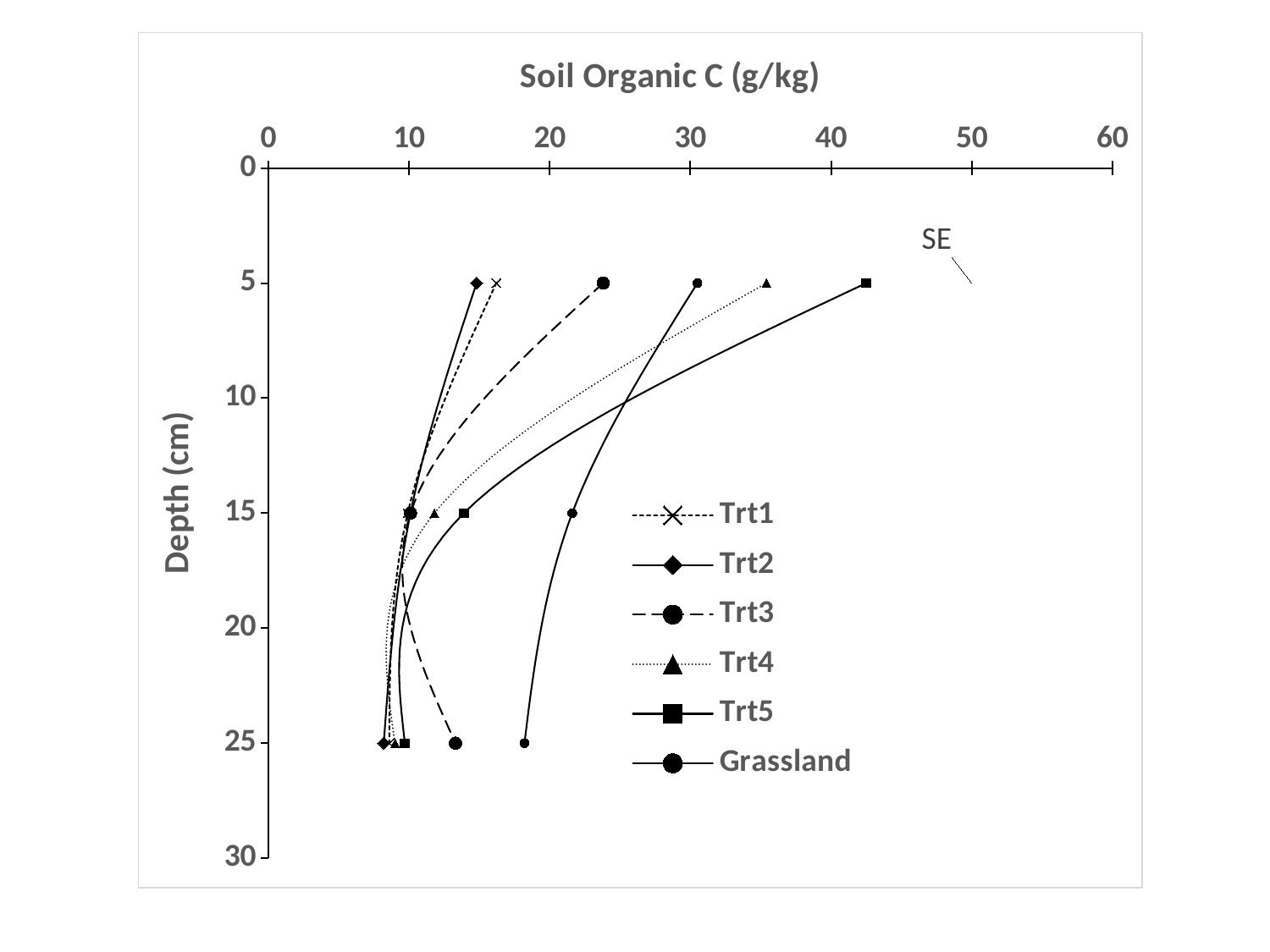
What kind of chart is shown on the slide? line chart Is the Soil Organic C value for Grassland at 5 cm depth greater or less than 20? greater How many series does the legend list? 6 At a depth of 5 cm, which has the larger Soil Organic C value, Trt4 or Trt3? Trt4 Is the Soil Organic C value for Trt5 at 5 cm depth greater or less than 40? greater How many depth points are plotted for each series? 3 Does the Soil Organic C value for Trt5 increase or decrease as depth increases from 5 cm to 25 cm? decrease Which series has the highest Soil Organic C value at a depth of 25 cm? Grassland What is the title of the horizontal axis? Soil Organic C (g/kg) Which series has the highest Soil Organic C value at a depth of 5 cm? Trt5 Is the Soil Organic C value for Trt3 at 25 cm depth greater or less than 10? greater